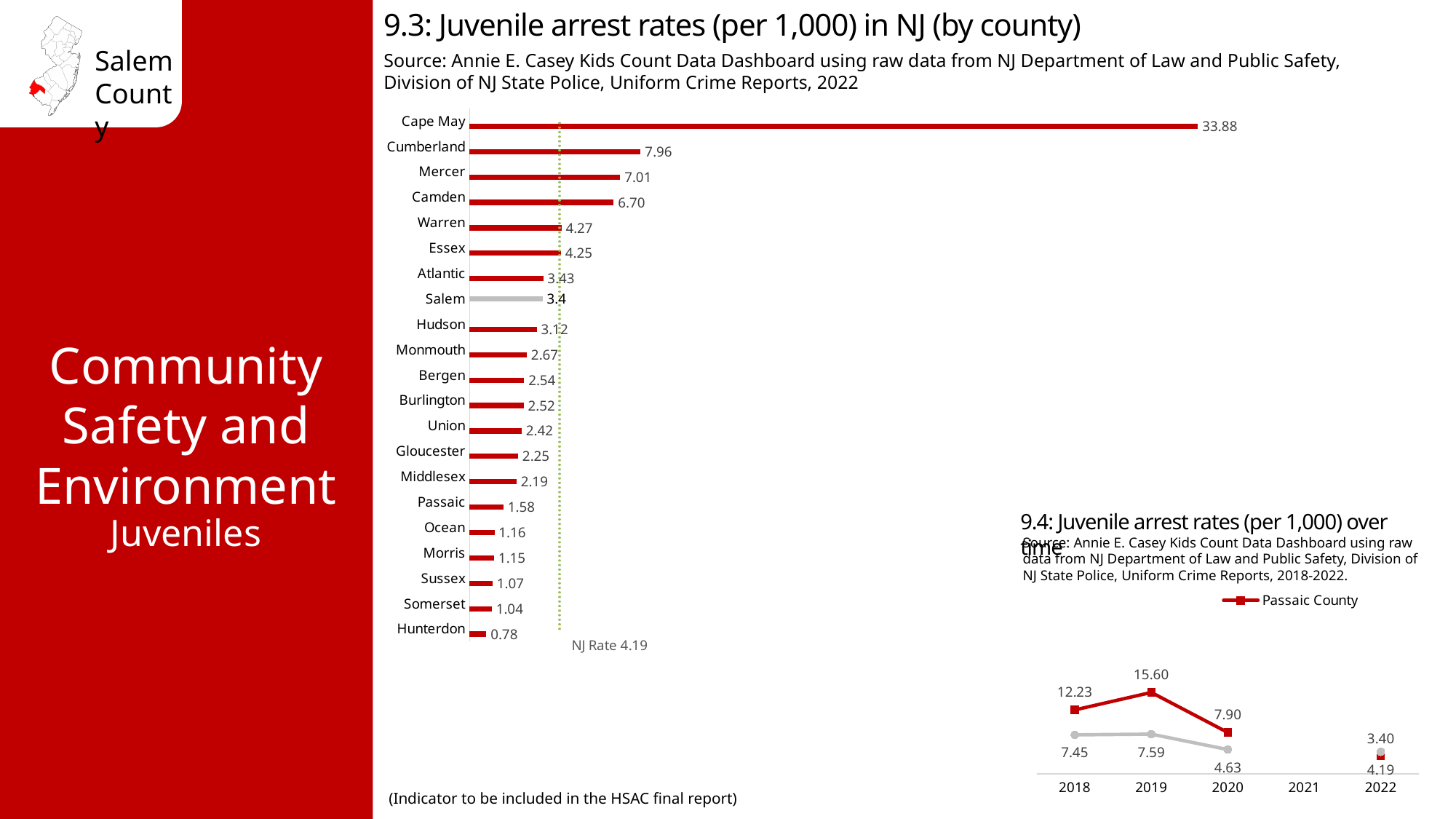
How many series does the legend list in the chart '9.4: Juvenile arrest rates (per 1,000) over time'? 1 In the chart '9.4: Juvenile arrest rates (per 1,000) over time', what is the value for Passaic County in 2019? 15.60 How many counties are shown in the chart '9.3: Juvenile arrest rates (per 1,000) in NJ (by county)'? 21 In the chart '9.4: Juvenile arrest rates (per 1,000) over time', what is the difference between the Passaic County values for 2018 and 2020? 4.33 What kind of chart is '9.3: Juvenile arrest rates (per 1,000) in NJ (by county)'? Bar chart In the chart '9.3: Juvenile arrest rates (per 1,000) in NJ (by county)', what is the difference between Cape May and Cumberland? 25.92 In the chart '9.3: Juvenile arrest rates (per 1,000) in NJ (by county)', which is larger, the value for Mercer or the value for Camden? Mercer In the chart '9.3: Juvenile arrest rates (per 1,000) in NJ (by county)', what NJ rate is marked by the dotted line? 4.19 In the chart '9.3: Juvenile arrest rates (per 1,000) in NJ (by county)', what is the value for Salem? 3.4 In the chart '9.3: Juvenile arrest rates (per 1,000) in NJ (by county)', which county has the lowest rate? Hunterdon In the chart '9.3: Juvenile arrest rates (per 1,000) in NJ (by county)', what is the value for Cumberland? 7.96 In the chart '9.3: Juvenile arrest rates (per 1,000) in NJ (by county)', which county has the highest rate? Cape May